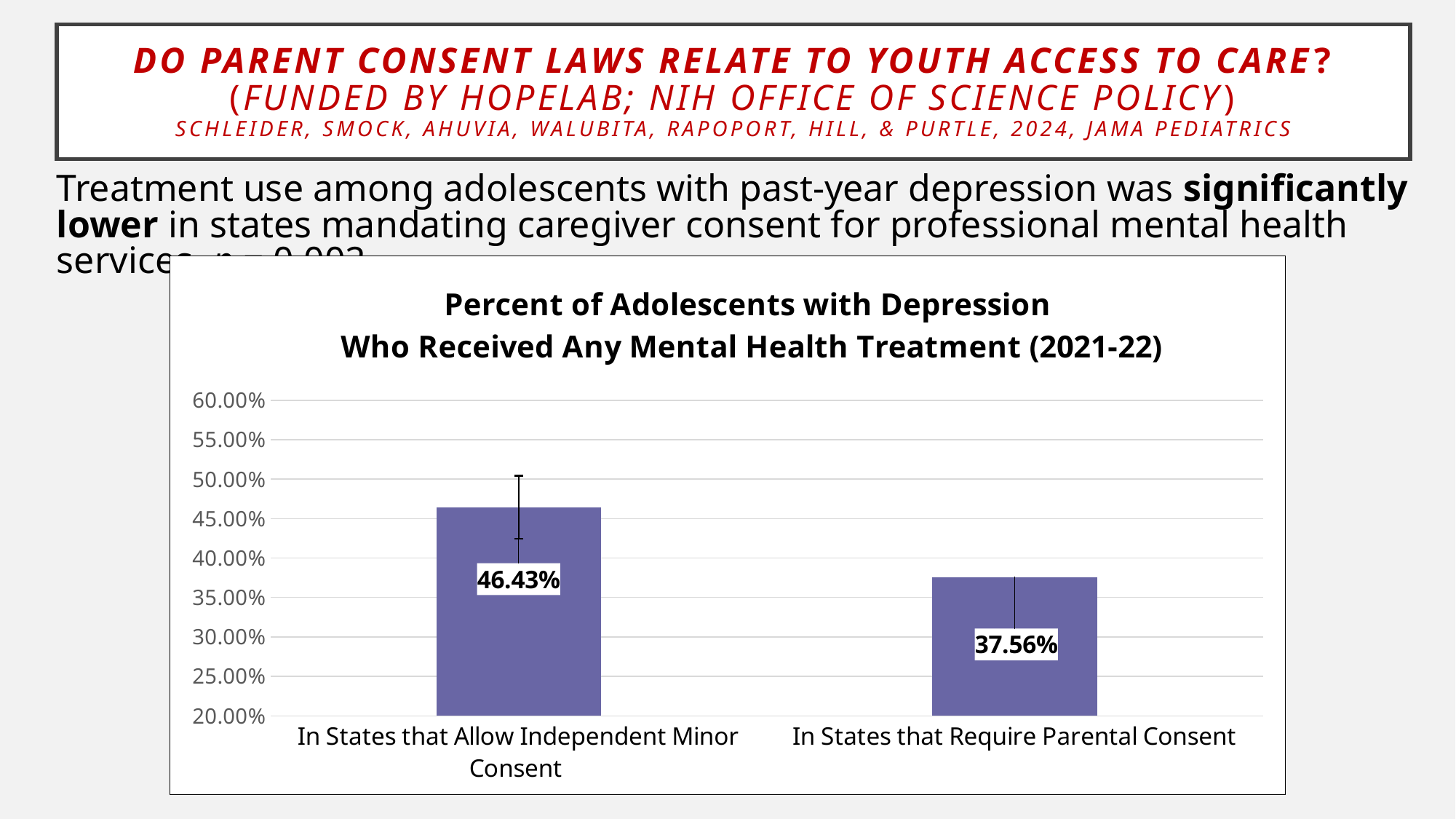
What percent of adolescents with depression received any mental health treatment in states that require parental consent? 37.56% Is the value for states that allow independent minor consent greater or less than 45.00%? greater What is the title of the chart? Percent of Adolescents with Depression Who Received Any Mental Health Treatment (2021-22) What is the lowest value shown on the chart's vertical axis? 20.00% Is the value for states that require parental consent greater or less than 40.00%? less What percent of adolescents with depression received any mental health treatment in states that allow independent minor consent? 46.43% Which category has the lower percentage of adolescents receiving treatment? In States that Require Parental Consent Which category has the higher percentage of adolescents receiving treatment? In States that Allow Independent Minor Consent How many categories are shown on the chart? 2 Is the value for states that allow independent minor consent larger or smaller than the value for states that require parental consent? larger What is the difference in percentage points between states that allow independent minor consent and states that require parental consent? 8.87% What kind of chart is shown on the slide? Bar chart